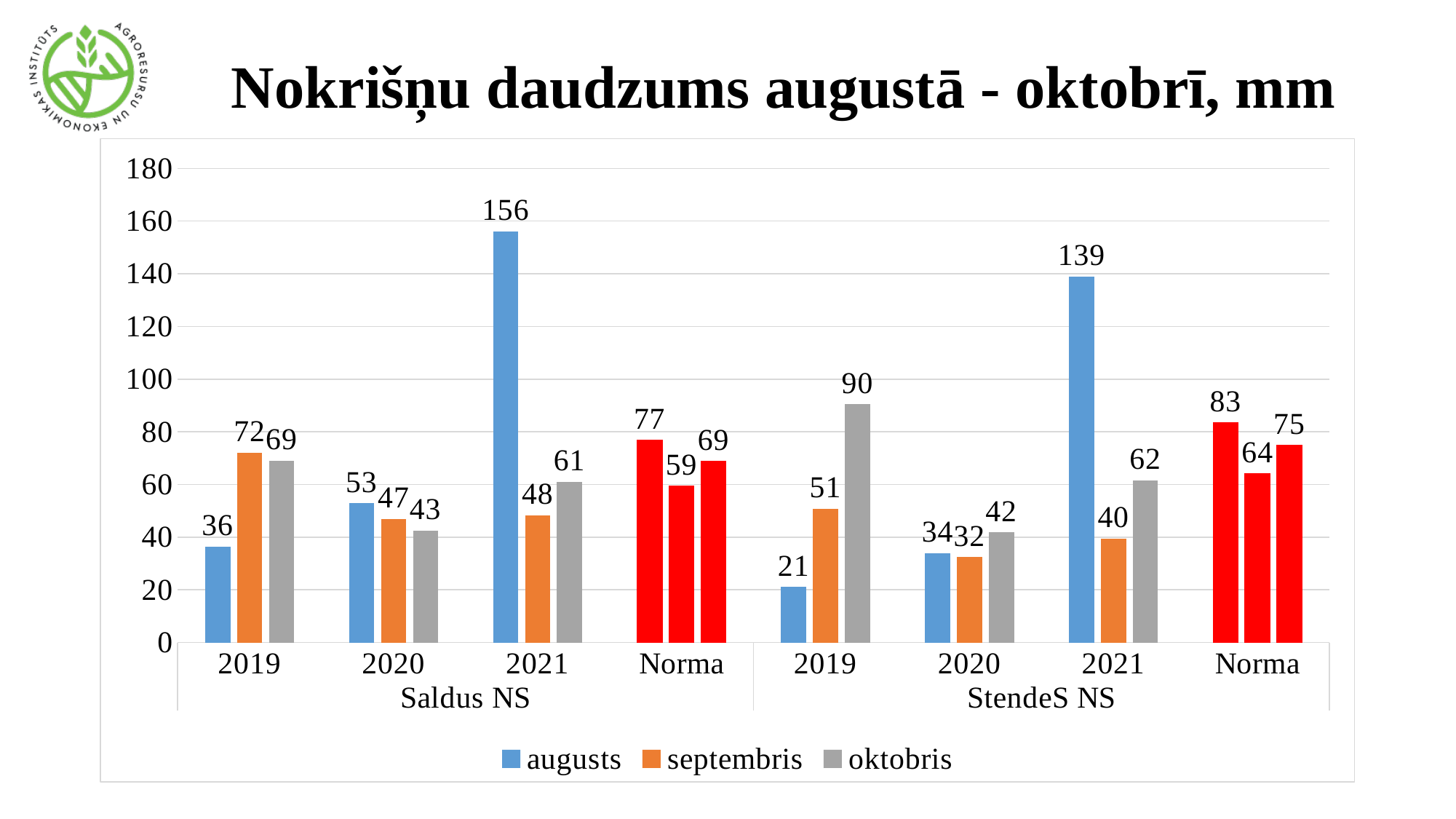
Is the augusts value for 2021 at StendeS NS greater or less than 120? greater What is the title of the chart? Nokrišņu daudzums augustā - oktobrī, mm What is the septembris value for Norma at StendeS NS? 64 Which year has the highest augusts value at StendeS NS? 2021 Which is larger: the oktobris value for 2019 at Saldus NS or the oktobris value for 2019 at StendeS NS? StendeS NS What is the oktobris value for 2019 at StendeS NS? 90 What is the total of the three Norma values at Saldus NS? 205 What is the augusts value for 2021 at Saldus NS? 156 Which year has the lowest augusts value at Saldus NS? 2019 What is the difference between the augusts values for 2021 at Saldus NS and at StendeS NS? 17 How many series does the legend list? 3 What kind of chart is shown on the slide? bar chart